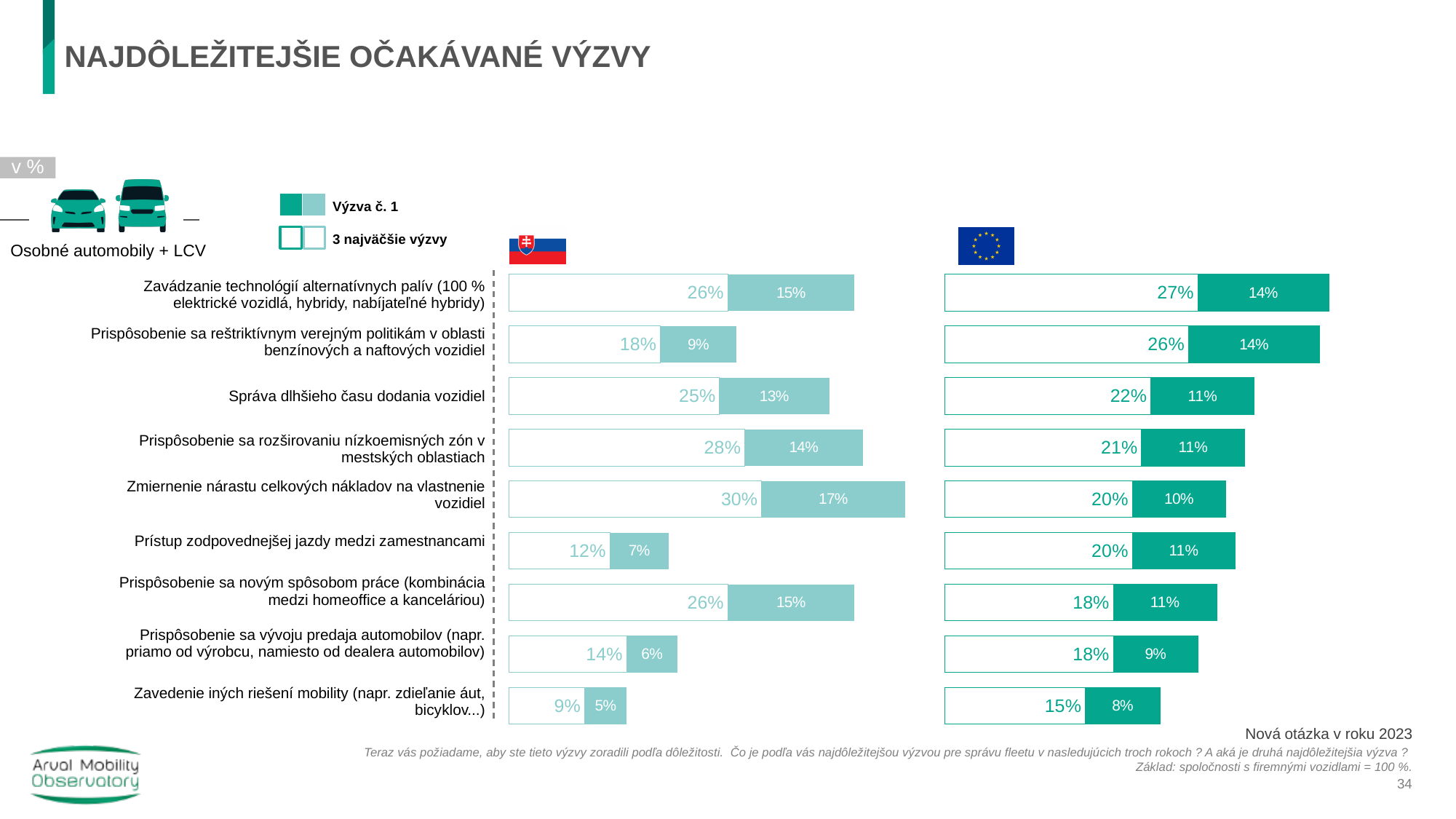
What kind of chart is used on this slide? Bar chart How many categories are shown in the Slovakia chart? 9 In the Slovakia chart, which category has the highest '3 najväčšie výzvy' value? Zmiernenie nárastu celkových nákladov na vlastnenie vozidiel How many series does the legend list? 2 In the Slovakia chart, what is the 'Výzva č. 1' value for 'Prístup zodpovednejšej jazdy medzi zamestnancami'? 7% What is the title of the slide? NAJDÔLEŽITEJŠIE OČAKÁVANÉ VÝZVY In the Slovakia chart (left, with the Slovak flag), what is the '3 najväčšie výzvy' value for 'Zmiernenie nárastu celkových nákladov na vlastnenie vozidiel'? 30% For 'Správa dlhšieho času dodania vozidiel', is the '3 najväčšie výzvy' value larger in the Slovakia chart or the EU chart? Slovakia chart In the EU chart, which category has the lowest '3 najväčšie výzvy' value? Zavedenie iných riešení mobility (napr. zdieľanie áut, bicyklov...) In the EU chart (right, with the EU flag), what is the 'Výzva č. 1' value for 'Zavádzanie technológií alternatívnych palív'? 14% In the Slovakia chart, what is the difference between the '3 najväčšie výzvy' value and the 'Výzva č. 1' value for 'Prispôsobenie sa rozširovaniu nízkoemisných zón v mestských oblastiach'? 14% In the EU chart, what is the 'Výzva č. 1' value for 'Prispôsobenie sa vývoju predaja automobilov'? 9%